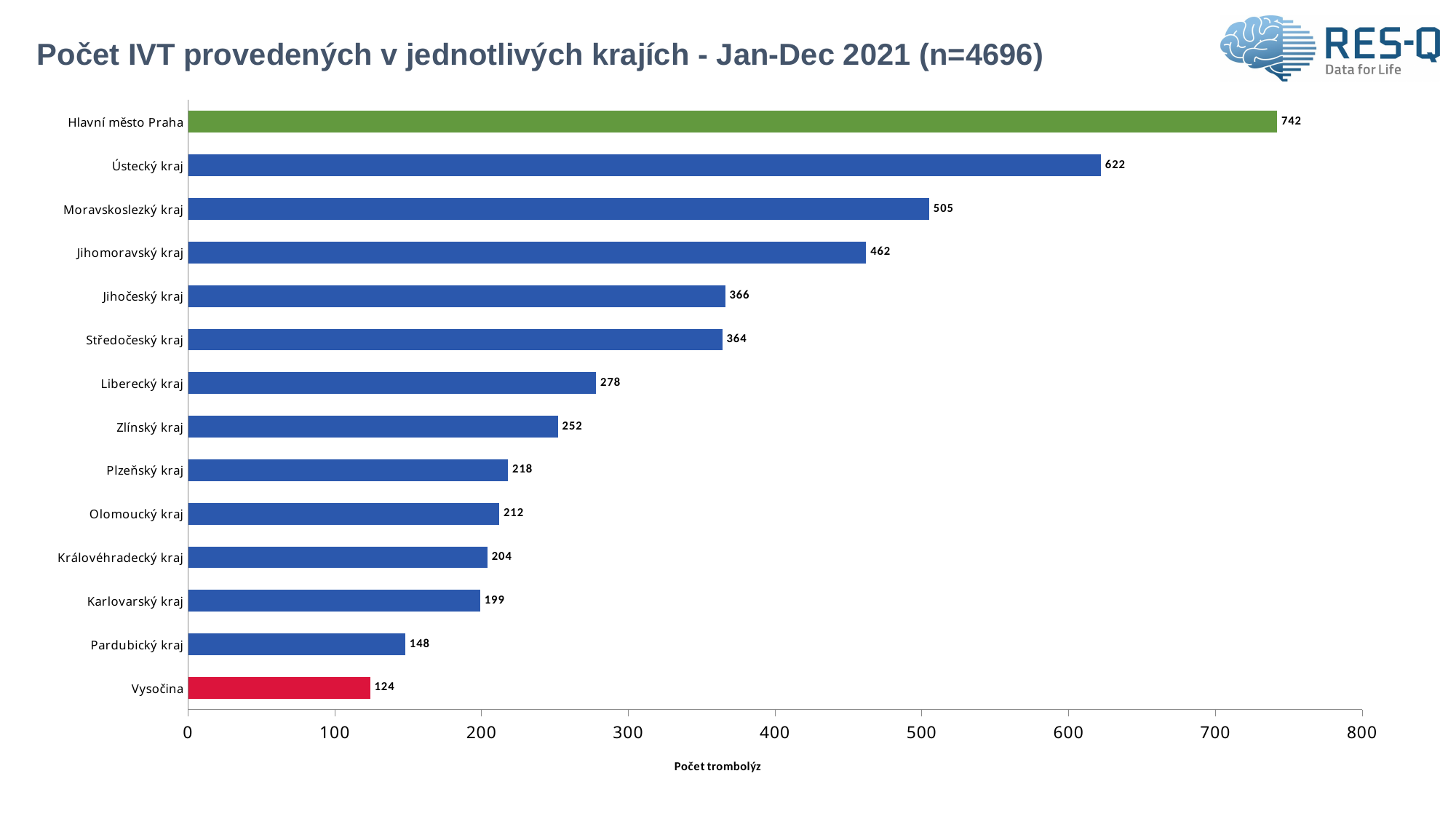
Which region has the lowest value? Vysočina What is the value for Karlovarský kraj? 199 What is the value for Liberecký kraj? 278 What is the label of the x axis? Počet trombolýz What is the value for Hlavní město Praha? 742 What kind of chart is shown on the slide? bar chart Which has a larger value, Jihomoravský kraj or Jihočeský kraj? Jihomoravský kraj What is the difference between the values for Hlavní město Praha and Vysočina? 618 What is the difference between the values for Ústecký kraj and Moravskoslezký kraj? 117 Is the value for Zlínský kraj greater or less than 300? less How many regions are shown in the chart? 14 Which region has the highest value? Hlavní město Praha